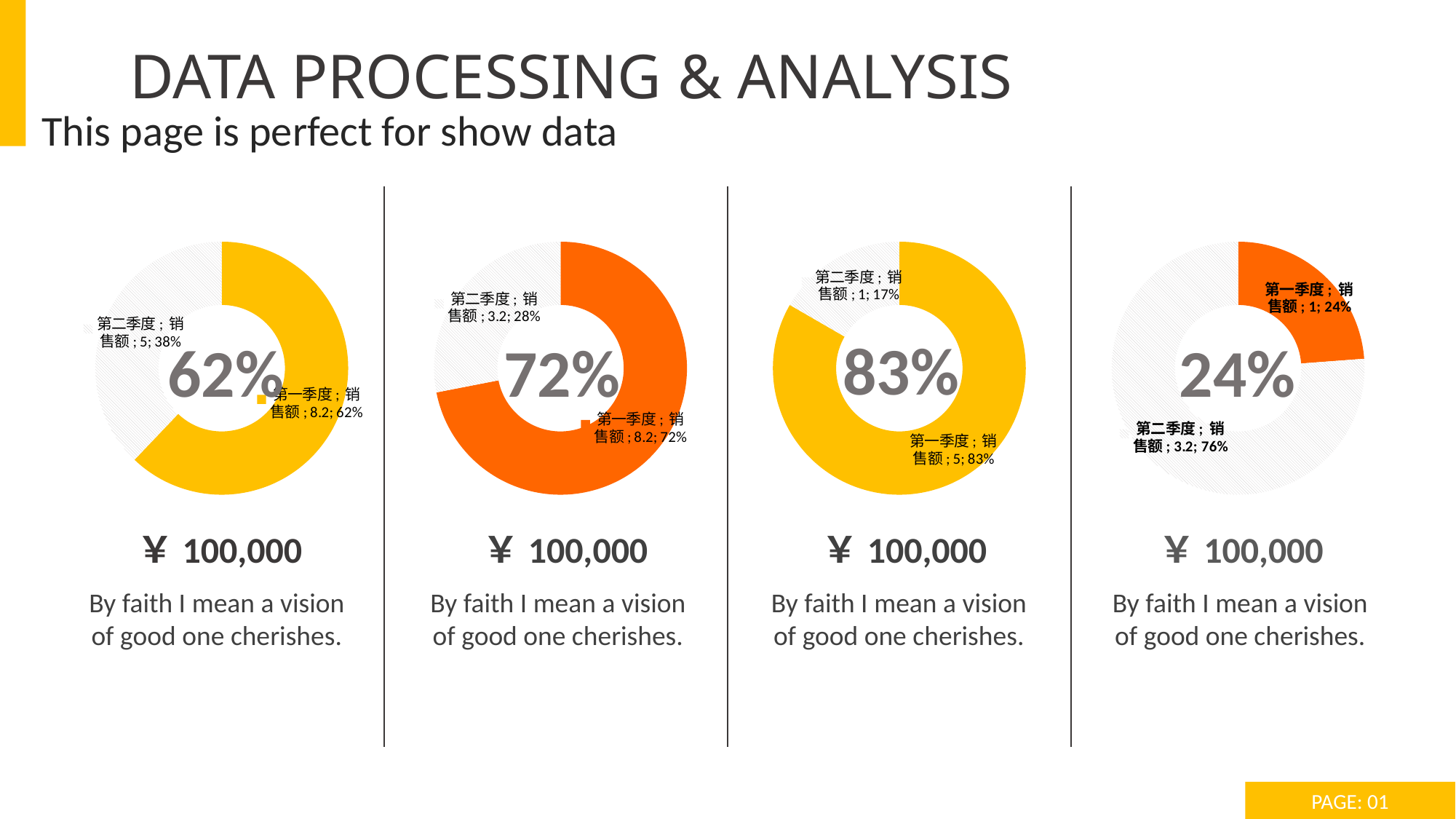
What type of chart is used for each of the four charts on the slide? Pie chart (donut) In the second chart from the left, what share does 第二季度 销售额 have? 28% In the third chart from the left, which slice is larger, 第一季度 销售额 or 第二季度 销售额? 第一季度 销售额 In the second chart from the left, what is the value for 第一季度 销售额? 8.2 What percentage is printed in the centre of the second chart from the left? 72% In the third chart from the left, what is the value for 第二季度 销售额? 1 How many slices does the leftmost chart have? 2 In the third chart from the left, what is the total of the two slice values? 6 In the leftmost chart, what is the value for 第二季度 销售额? 5 In the rightmost chart, what is the difference between the values for 第二季度 销售额 and 第一季度 销售额? 2.2 In the leftmost chart, what share does 第一季度 销售额 have? 62% In the rightmost chart, what share does 第二季度 销售额 have? 76%